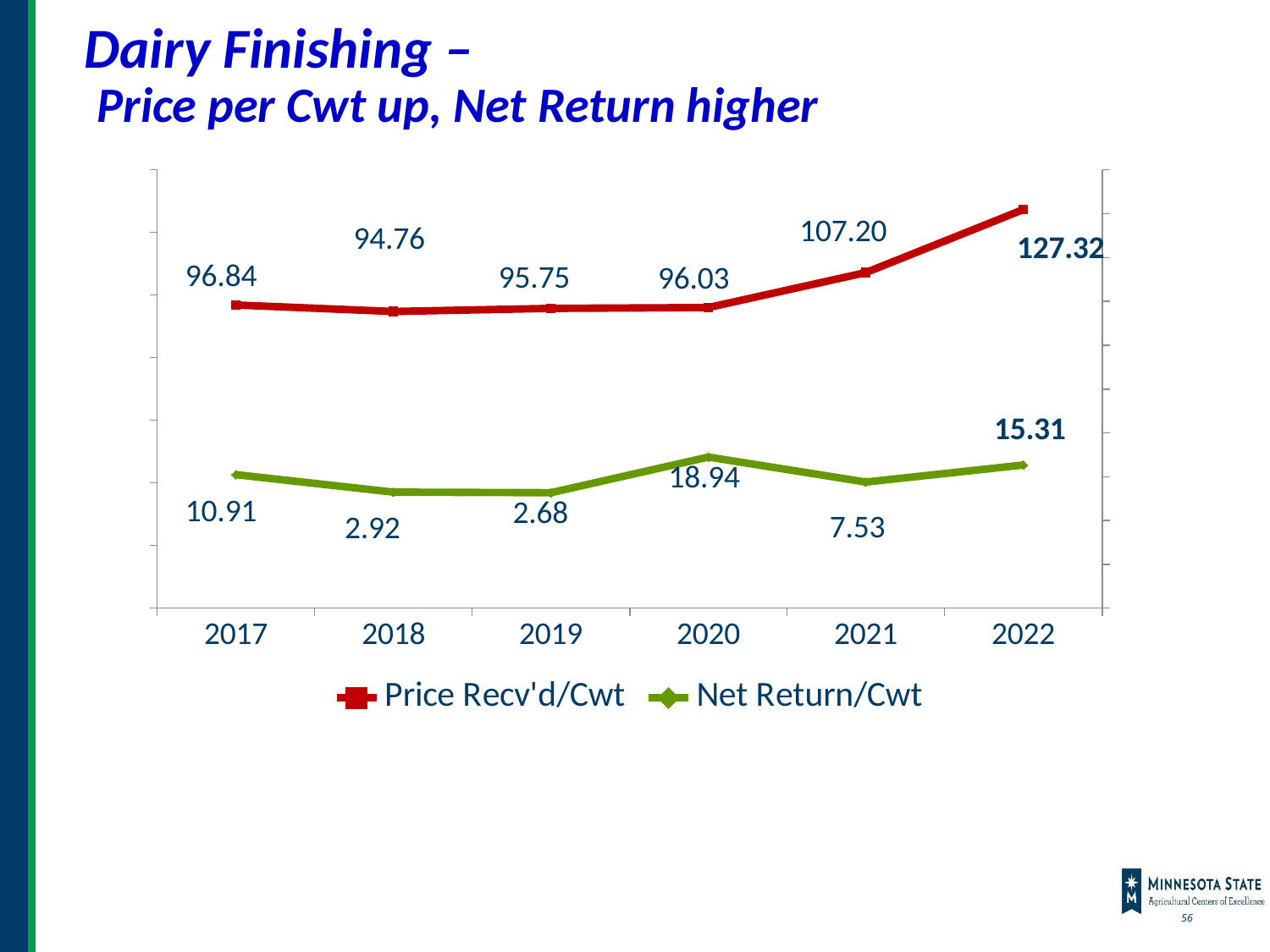
What is the Net Return/Cwt value for 2020? 18.94 How many series does the legend list? 2 What is the Price Recv'd/Cwt value for 2022? 127.32 How many years are plotted on the x axis? 6 What is the difference between the Price Recv'd/Cwt values for 2022 and 2021? 20.12 In which year is Net Return/Cwt lowest? 2019 In which year is Price Recv'd/Cwt highest? 2022 What type of chart is shown on the slide? Line chart Which is larger, the Net Return/Cwt for 2017 or for 2021? 2017 What is the Price Recv'd/Cwt value for 2018? 94.76 Does Price Recv'd/Cwt rise or fall from 2020 to 2022? Rise What colour is the Net Return/Cwt line? Green